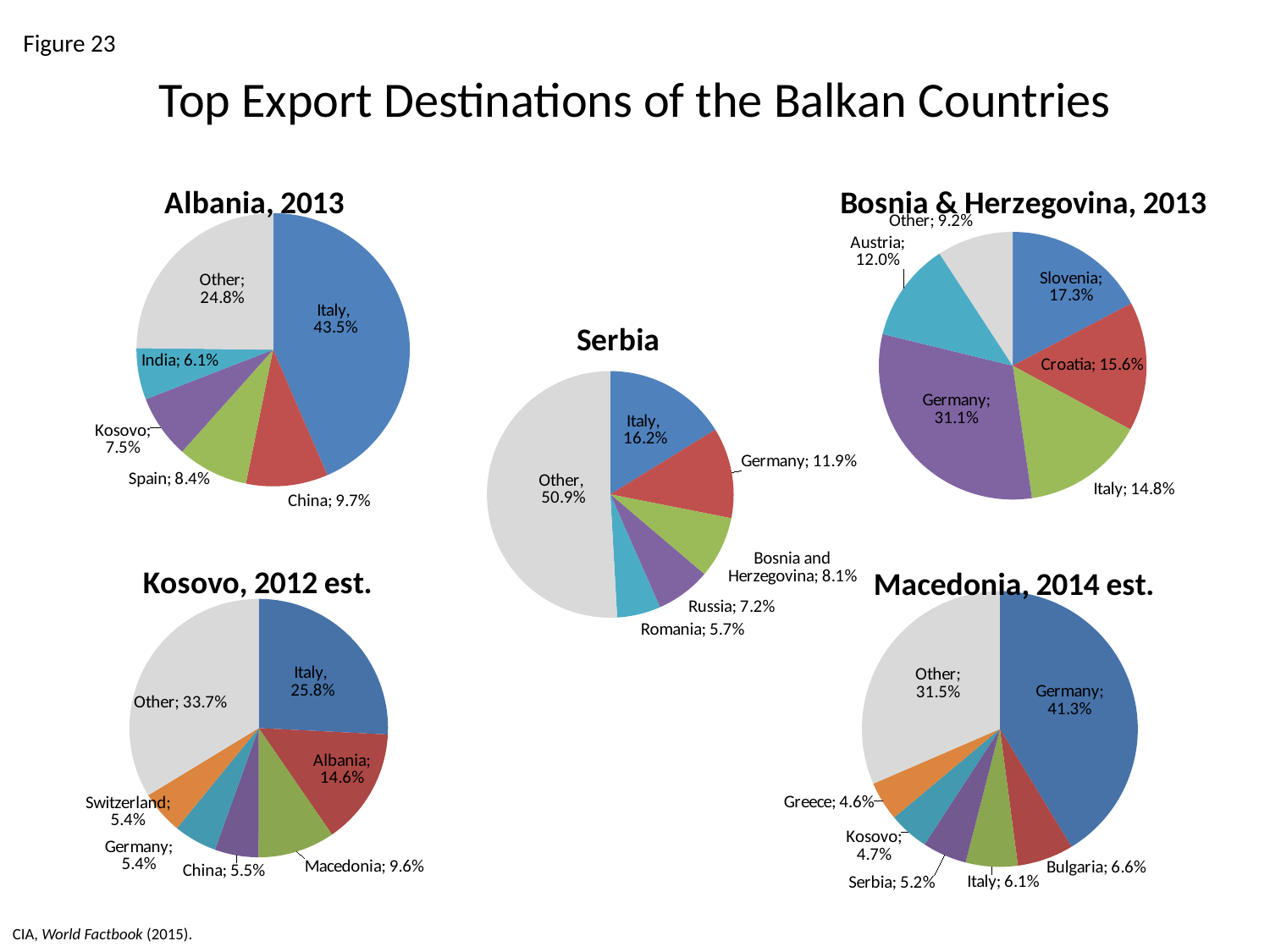
What type of chart is used for Macedonia, 2014 est.? Pie chart How many slices does the Serbia pie chart have? 6 In the Albania, 2013 pie chart, what is the difference between Italy's share and China's share? 33.8% In the Kosovo, 2012 est. pie chart, which is larger: the share for Albania or the share for Macedonia? Albania In the Serbia pie chart, which named destination has the smallest slice? Romania In the Albania, 2013 pie chart, what share of exports goes to Italy? 43.5% In the Macedonia, 2014 est. pie chart, which destination has the largest slice? Germany In the Bosnia & Herzegovina, 2013 pie chart, how much larger is Slovenia's share than Croatia's? 1.7% In the Kosovo, 2012 est. pie chart, what is the share labelled Other? 33.7% How many pie charts are shown on the slide? 5 In the Serbia pie chart, what share of exports goes to Russia? 7.2% In the Bosnia & Herzegovina, 2013 pie chart, what is Germany's share? 31.1%